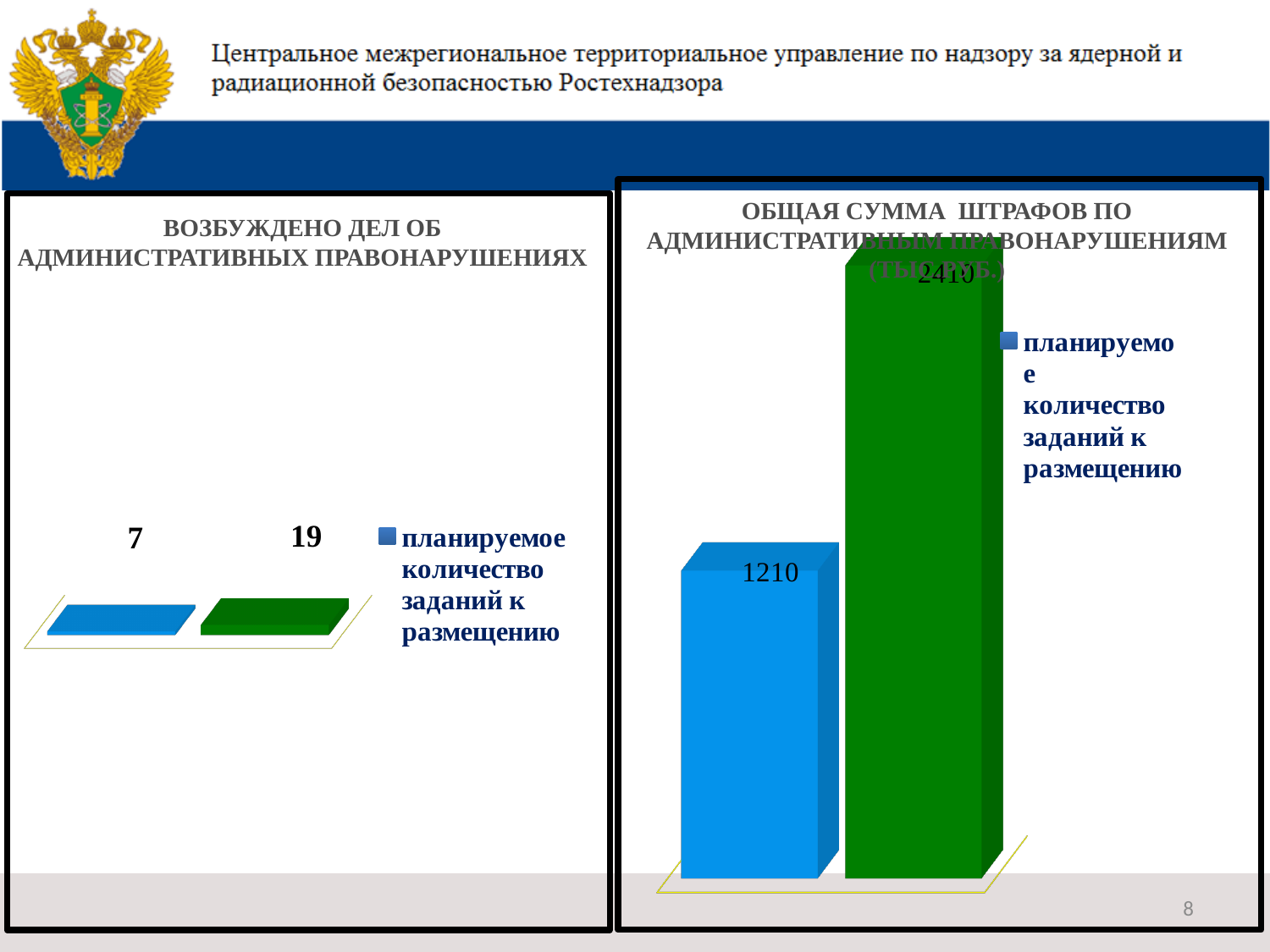
On the right chart (ОБЩАЯ СУММА ШТРАФОВ ПО АДМИНИСТРАТИВНЫМ ПРАВОНАРУШЕНИЯМ), what value is shown on the blue bar? 1210 On the right chart (ОБЩАЯ СУММА ШТРАФОВ ПО АДМИНИСТРАТИВНЫМ ПРАВОНАРУШЕНИЯМ), which bar has the highest value? the green bar (2410) On the left chart (ВОЗБУЖДЕНО ДЕЛ ОБ АДМИНИСТРАТИВНЫХ ПРАВОНАРУШЕНИЯХ), which bar is larger, the blue one or the green one? the green one What kind of chart is the right chart (ОБЩАЯ СУММА ШТРАФОВ ПО АДМИНИСТРАТИВНЫМ ПРАВОНАРУШЕНИЯМ)? bar chart How many series does the legend of the left chart (ВОЗБУЖДЕНО ДЕЛ ОБ АДМИНИСТРАТИВНЫХ ПРАВОНАРУШЕНИЯХ) list? 1 On the right chart (ОБЩАЯ СУММА ШТРАФОВ ПО АДМИНИСТРАТИВНЫМ ПРАВОНАРУШЕНИЯМ), what is the difference between the green bar and the blue bar? 1200 On the left chart (ВОЗБУЖДЕНО ДЕЛ ОБ АДМИНИСТРАТИВНЫХ ПРАВОНАРУШЕНИЯХ), what value is shown on the blue bar? 7 On the left chart (ВОЗБУЖДЕНО ДЕЛ ОБ АДМИНИСТРАТИВНЫХ ПРАВОНАРУШЕНИЯХ), what value is shown on the green bar? 19 On the right chart (ОБЩАЯ СУММА ШТРАФОВ ПО АДМИНИСТРАТИВНЫМ ПРАВОНАРУШЕНИЯМ), what value is shown on the green bar? 2410 How many bars are plotted on the left chart (ВОЗБУЖДЕНО ДЕЛ ОБ АДМИНИСТРАТИВНЫХ ПРАВОНАРУШЕНИЯХ)? 2 On the left chart (ВОЗБУЖДЕНО ДЕЛ ОБ АДМИНИСТРАТИВНЫХ ПРАВОНАРУШЕНИЯХ), what is the difference between the green bar and the blue bar? 12 On the right chart (ОБЩАЯ СУММА ШТРАФОВ ПО АДМИНИСТРАТИВНЫМ ПРАВОНАРУШЕНИЯМ), which bar has the lowest value? the blue bar (1210)